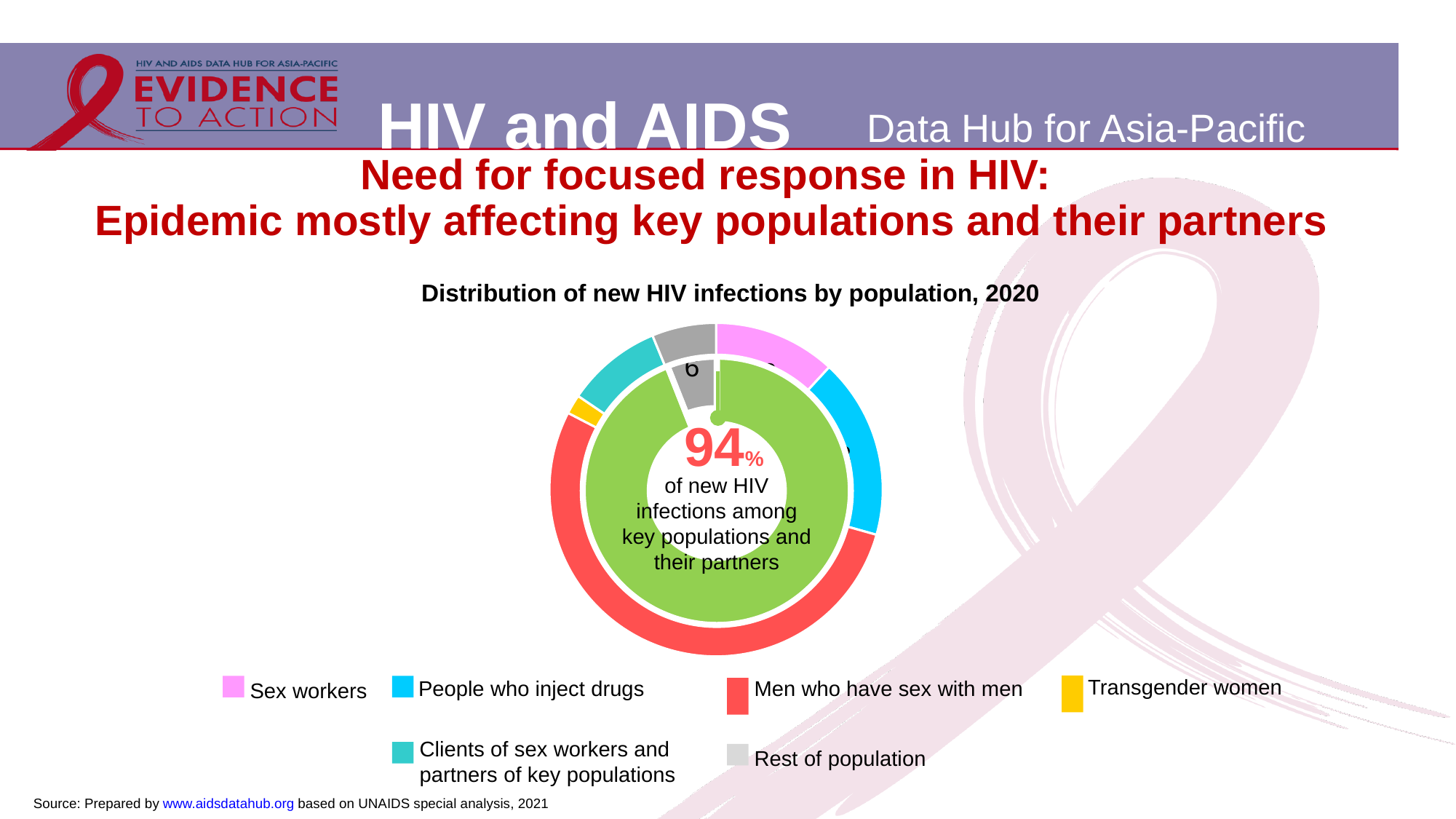
Which slice is larger: People who inject drugs or Transgender women? People who inject drugs Which population category has the smallest slice of the chart? Transgender women How many population categories does the legend list? 6 What is the title of the chart? Distribution of new HIV infections by population, 2020 Which population category has the largest slice of the chart? Men who have sex with men According to the text in the centre of the chart, what share of new HIV infections is among key populations and their partners? 94% What kind of chart is shown on the slide? Pie chart (donut) Which slice is larger: Men who have sex with men or Sex workers? Men who have sex with men What colour represents Sex workers in the chart? Pink Which slice is larger: Rest of population or Men who have sex with men? Men who have sex with men Which category is shown in grey in the chart? Rest of population